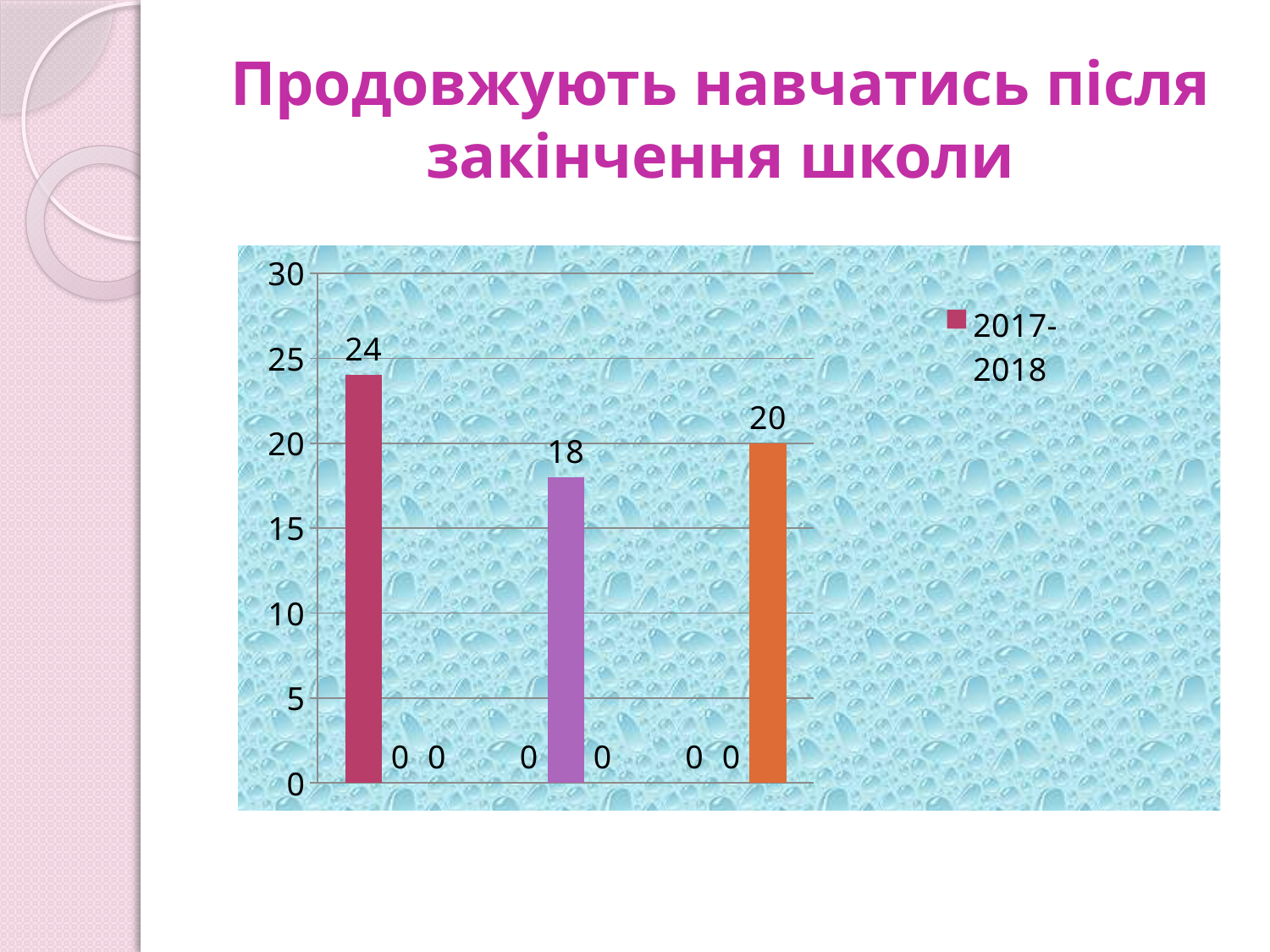
What is the value shown on the first (crimson) bar? 24 Is the value of the purple bar greater or less than 20? less Which is larger, the crimson bar or the orange bar? the crimson bar How many non-zero bars are plotted in the chart? 3 What is the difference between the orange bar (20) and the purple bar (18)? 2 What is the value shown on the third (orange) bar? 20 What is the value shown on the middle (purple) bar? 18 What is the highest value labelled on a bar in the chart? 24 What is the lowest non-zero value labelled on a bar in the chart? 18 What is the difference between the tallest bar (24) and the shortest non-zero bar (18)? 6 What kind of chart is shown on the slide? bar chart What is the only entry shown in the chart's legend? 2017-2018